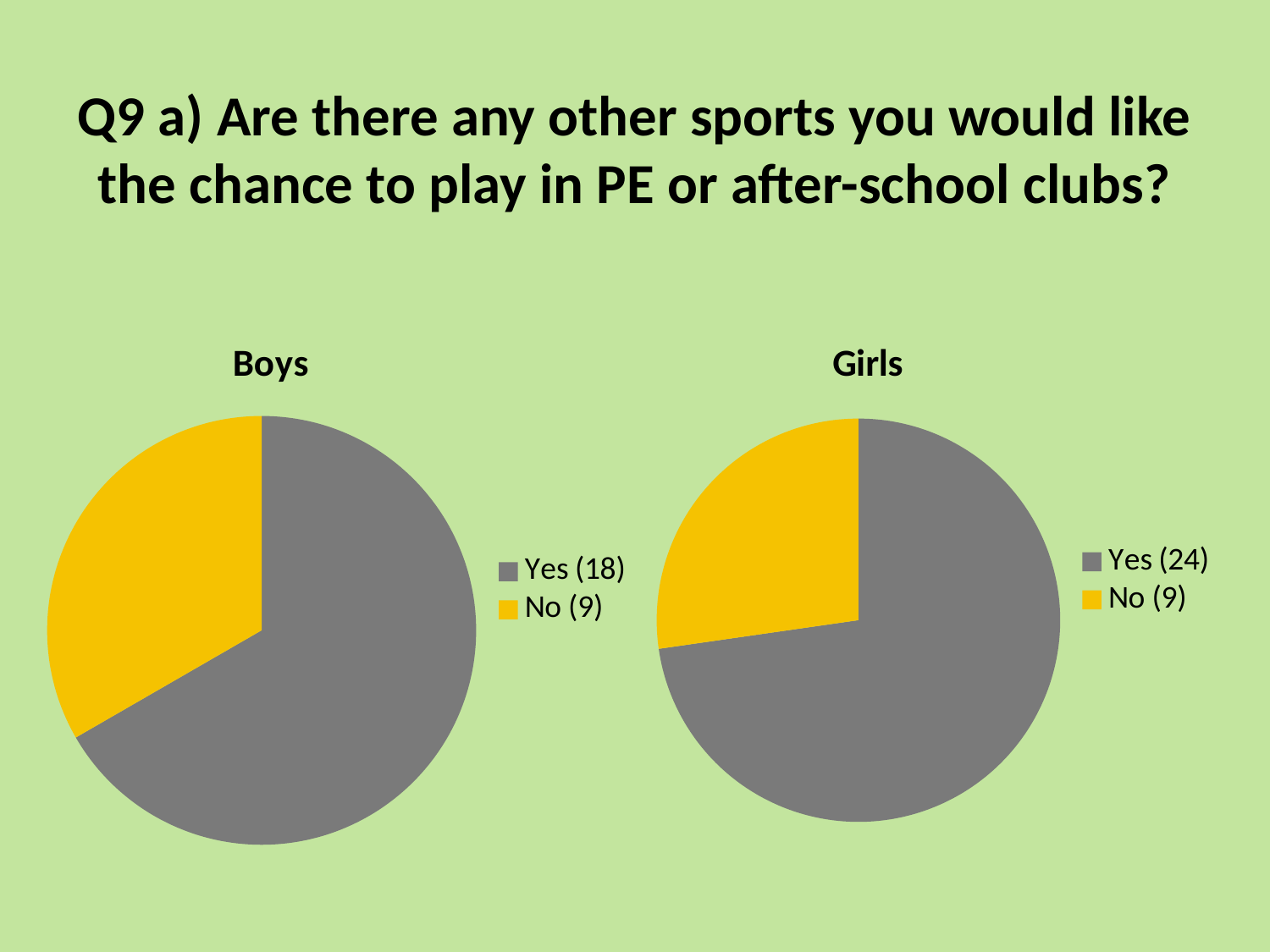
How many slices does the Boys chart have? 2 In the Girls chart, how many girls answered No? 9 In the Girls chart, what is the total number of responses? 33 In the Boys chart, which response has the larger slice? Yes In the Girls chart, which response has the smaller slice? No In the Boys chart, how many boys answered Yes? 18 What kind of chart is the Boys chart? Pie chart In the Boys chart, what colour is the No slice? Yellow Which is larger: the number of Yes responses in the Boys chart or in the Girls chart? Girls How many entries does the legend of the Girls chart list? 2 In the Boys chart, what is the difference between the number of Yes and No responses? 9 In the Girls chart, how many girls answered Yes? 24